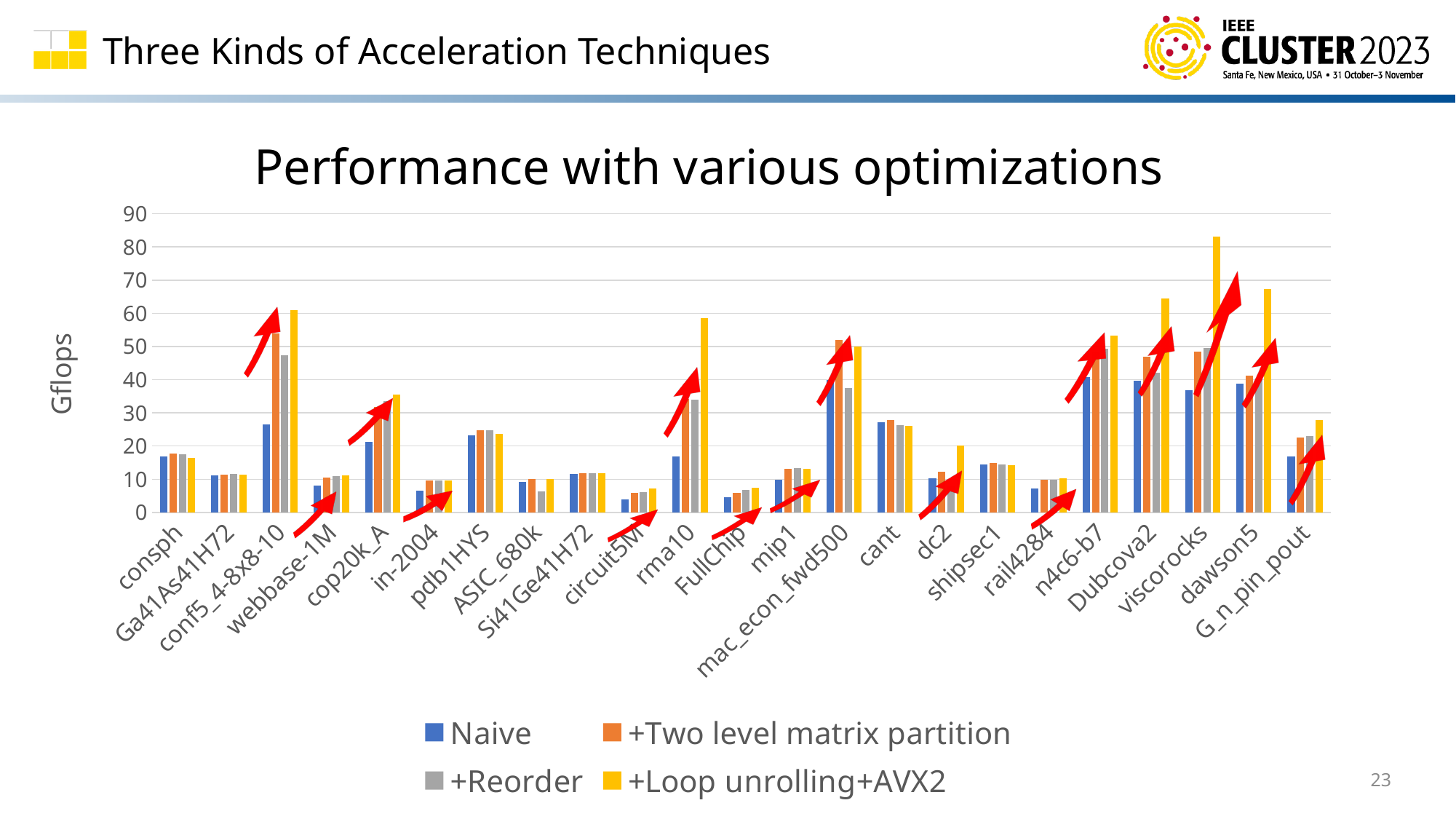
Which is larger: the +Loop unrolling+AVX2 value for viscorocks or for Dubcova2? viscorocks How many matrix categories are shown along the x axis? 23 What is the label of the y axis? Gflops Is the +Loop unrolling+AVX2 value for rma10 greater or less than 50? greater Is the Naive value for circuit5M greater or less than 10? less Which category has the lowest Naive value? circuit5M Is the +Loop unrolling+AVX2 value for viscorocks greater or less than 80? greater What kind of chart is shown on the slide? bar chart Which category has the highest +Loop unrolling+AVX2 value? viscorocks How many series does the legend list? 4 Which series is shown in yellow in the legend? +Loop unrolling+AVX2 Which is larger: the Naive value for cant or for consph? cant